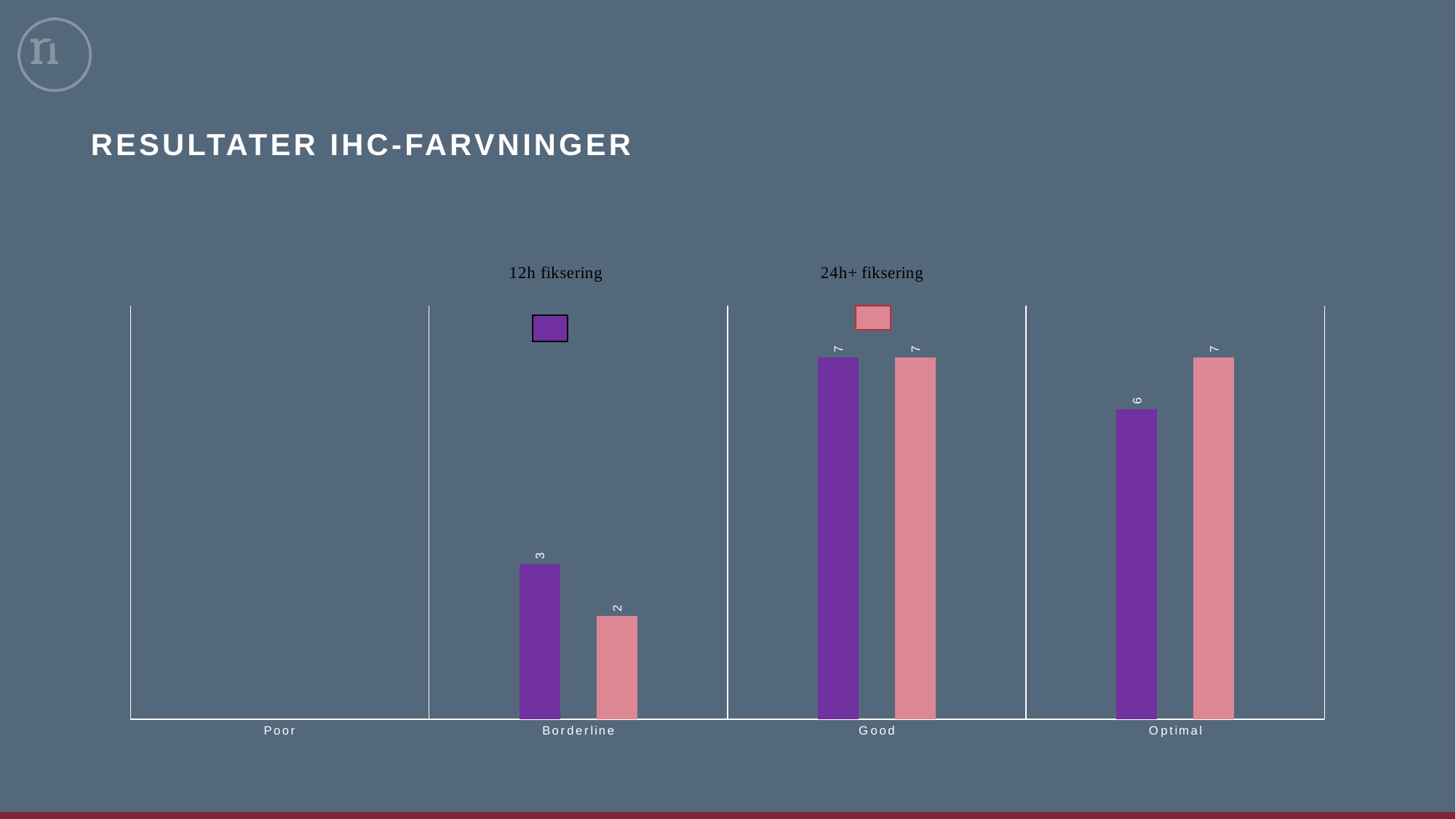
What is the value for 12h fiksering in the Optimal category? 6 In the Optimal category, which series has the larger value, 12h fiksering or 24h+ fiksering? 24h+ fiksering What is the value for 24h+ fiksering in the Borderline category? 2 What is the value for 12h fiksering in the Borderline category? 3 Which colour represents the 24h+ fiksering series? pink What kind of chart is shown on the slide? bar chart How many categories are shown on the x axis? 4 What is the value for 24h+ fiksering in the Optimal category? 7 What is the difference between the 12h fiksering and 24h+ fiksering values in the Borderline category? 1 Which category has the lowest value for 12h fiksering among the categories with bars? Borderline What is the value for 12h fiksering in the Good category? 7 How many series does the legend list? 2